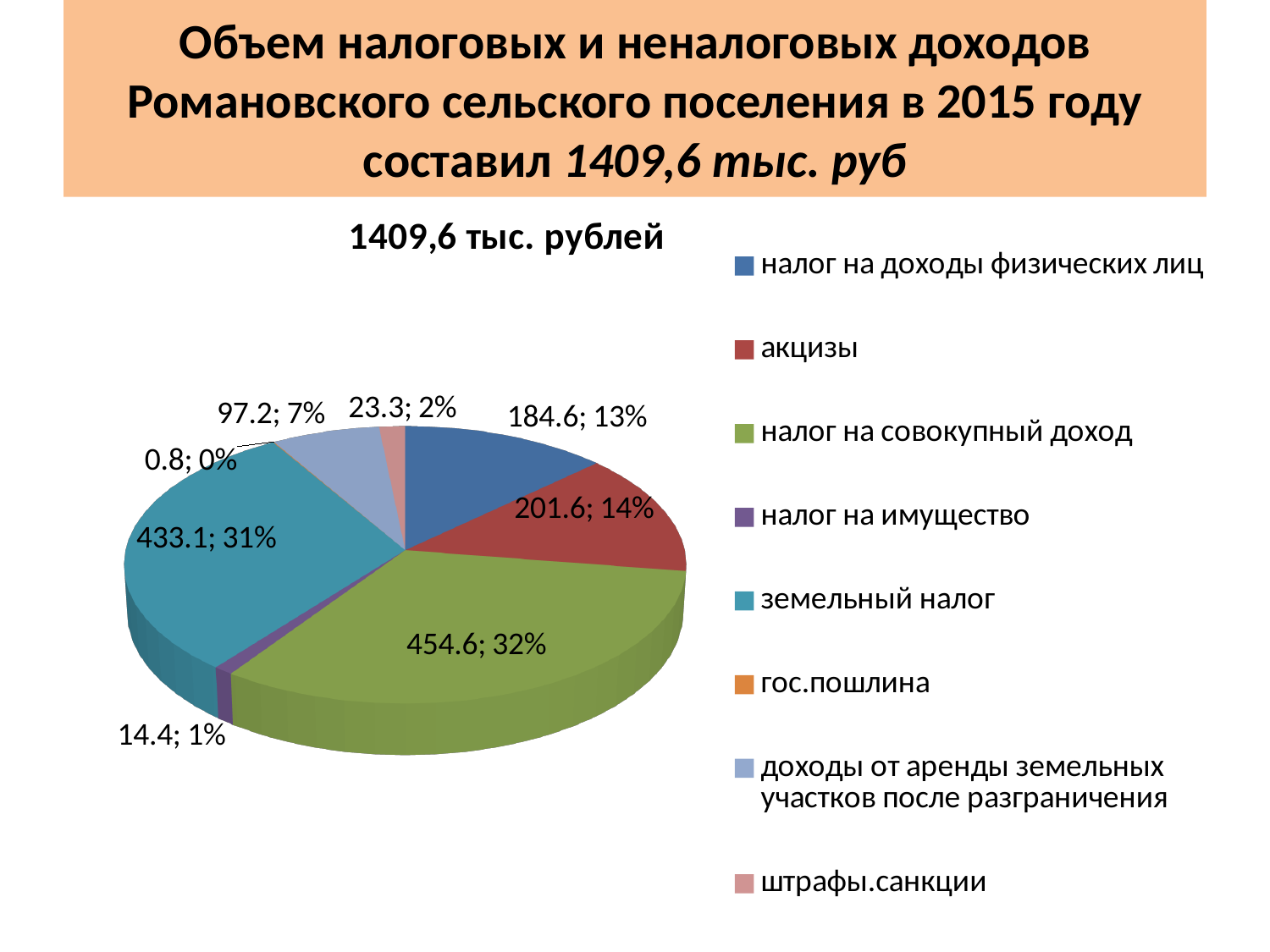
Which is larger, the value for штрафы.санкции or the value for налог на имущество? штрафы.санкции What value is shown for земельный налог? 433.1 What share of the pie does доходы от аренды земельных участков после разграничения represent? 7% What value is shown for налог на совокупный доход? 454.6 What kind of chart is shown on the slide? pie chart What is the title of the chart? 1409,6 тыс. рублей What value is shown for акцизы? 201.6 How many categories does the legend list? 8 What share of the pie does налог на доходы физических лиц represent? 13% What is the difference between the values for акцизы and налог на доходы физических лиц? 17.0 Which category has the smallest slice? гос.пошлина Which category has the largest slice? налог на совокупный доход